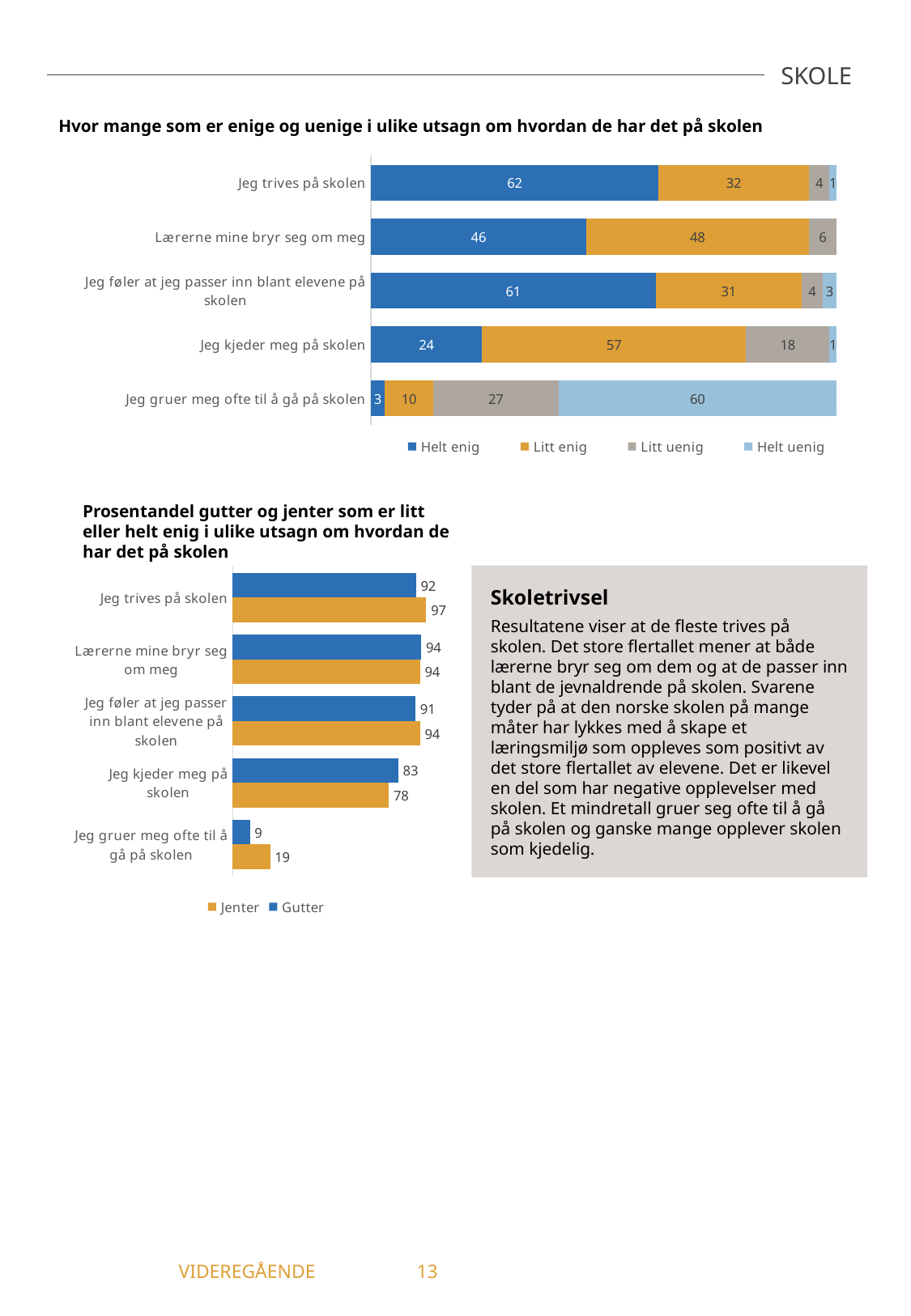
What kind of chart is the bottom chart? Bar chart In the top chart, what is the 'Helt enig' value for 'Jeg trives på skolen'? 62 In the top chart, what is the 'Helt uenig' value for 'Jeg gruer meg ofte til å gå på skolen'? 60 In the top chart, which statement has the highest 'Litt enig' value? Jeg kjeder meg på skolen In the top chart, which statement has the lowest 'Helt enig' value? Jeg gruer meg ofte til å gå på skolen In the top chart, what is the total of the 'Helt enig' and 'Litt enig' segments for 'Jeg kjeder meg på skolen'? 81 In the bottom chart, what is the value for Jenter for 'Jeg trives på skolen'? 97 In the top chart, how many series does the legend list? 4 In the bottom chart, what is the difference between Jenter and Gutter for 'Jeg gruer meg ofte til å gå på skolen'? 10 In the bottom chart, which is larger for 'Jeg kjeder meg på skolen': Gutter or Jenter? Gutter In the top chart, what is the difference between the 'Litt enig' values for 'Lærerne mine bryr seg om meg' and 'Jeg trives på skolen'? 16 In the bottom chart, what is the value for Gutter for 'Jeg gruer meg ofte til å gå på skolen'? 9